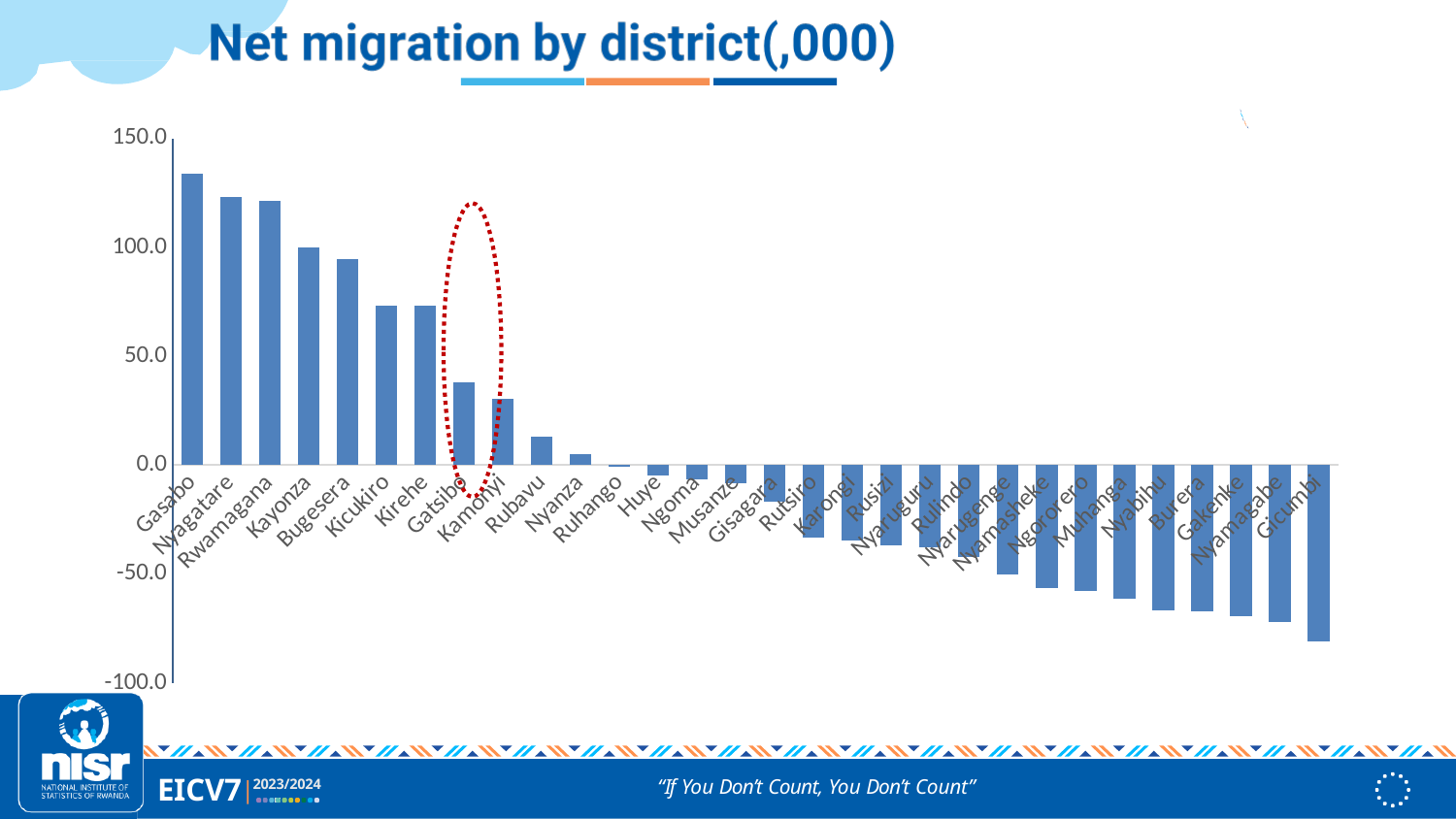
Which district has a larger net migration, Gasabo or Nyagatare? Gasabo Do the values rise or fall moving from left to right along the x axis? Fall Is the value for Gicumbi greater or less than -50.0? less How many districts are plotted on the chart? 30 What is the title of the chart? Net migration by district(,000) Which district has the lowest net migration? Gicumbi Is the value for Gatsibo greater or less than 50.0? less Which district has the highest net migration? Gasabo What kind of chart is shown on the slide? Bar chart Which district has a larger net migration, Gatsibo or Kamonyi? Gatsibo Is the value for Gasabo greater or less than 100.0? greater